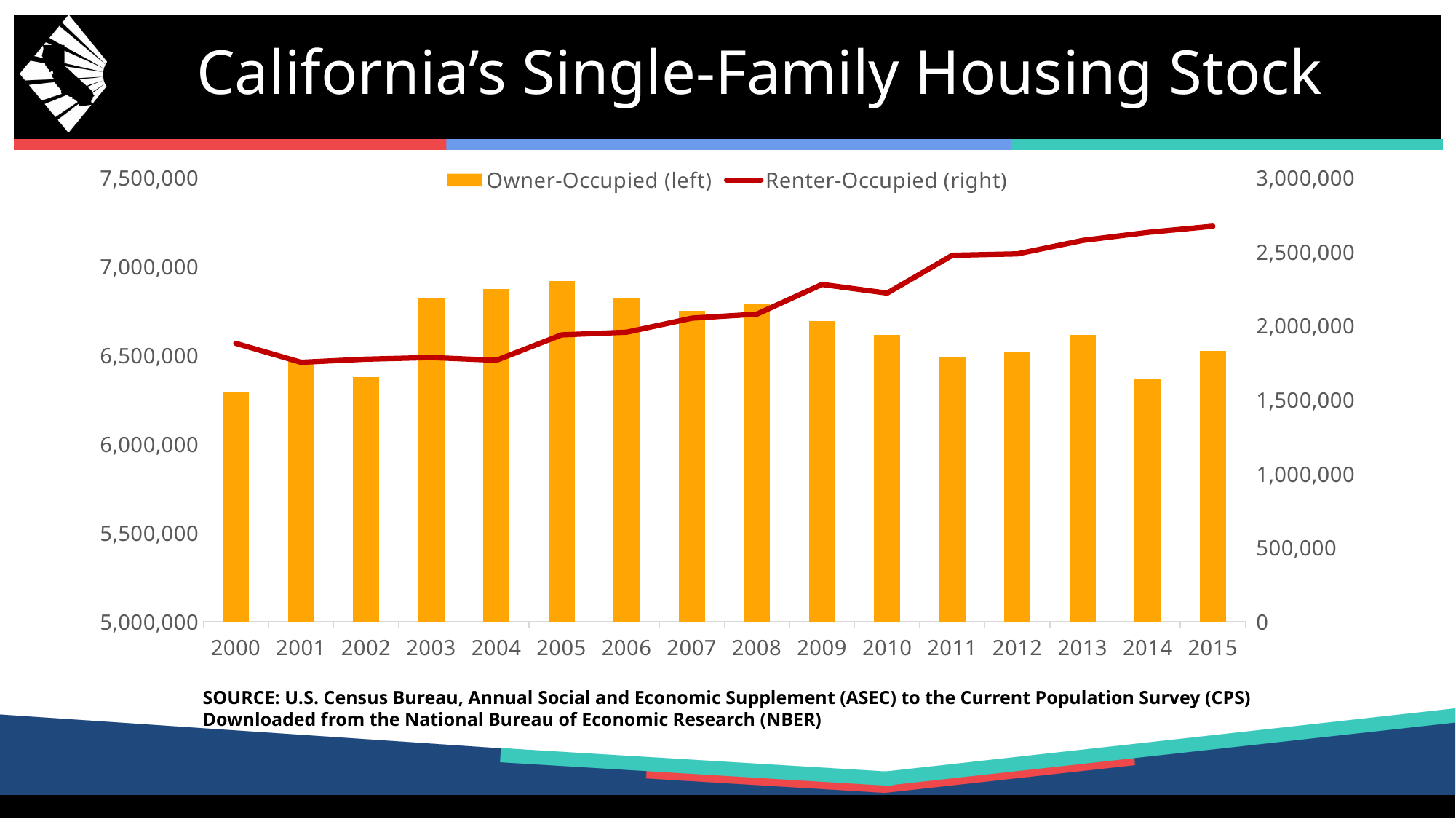
In which year is the Owner-Occupied bar lowest? 2000 Is the Owner-Occupied value for 2005 greater or less than 6,500,000? greater What kind of chart is shown on the slide? A combined bar and line chart How many series does the legend list? 2 How many years are shown on the x axis? 16 Does the Renter-Occupied line generally rise or fall from 2000 to 2015? Rise In which year does the Renter-Occupied line reach its highest value? 2015 Which year has the larger Owner-Occupied value, 2013 or 2014? 2013 Is the Renter-Occupied value for 2000 greater or less than 2,000,000? less Is the Renter-Occupied value for 2015 greater or less than 2,500,000? greater In which year is the Owner-Occupied bar highest? 2005